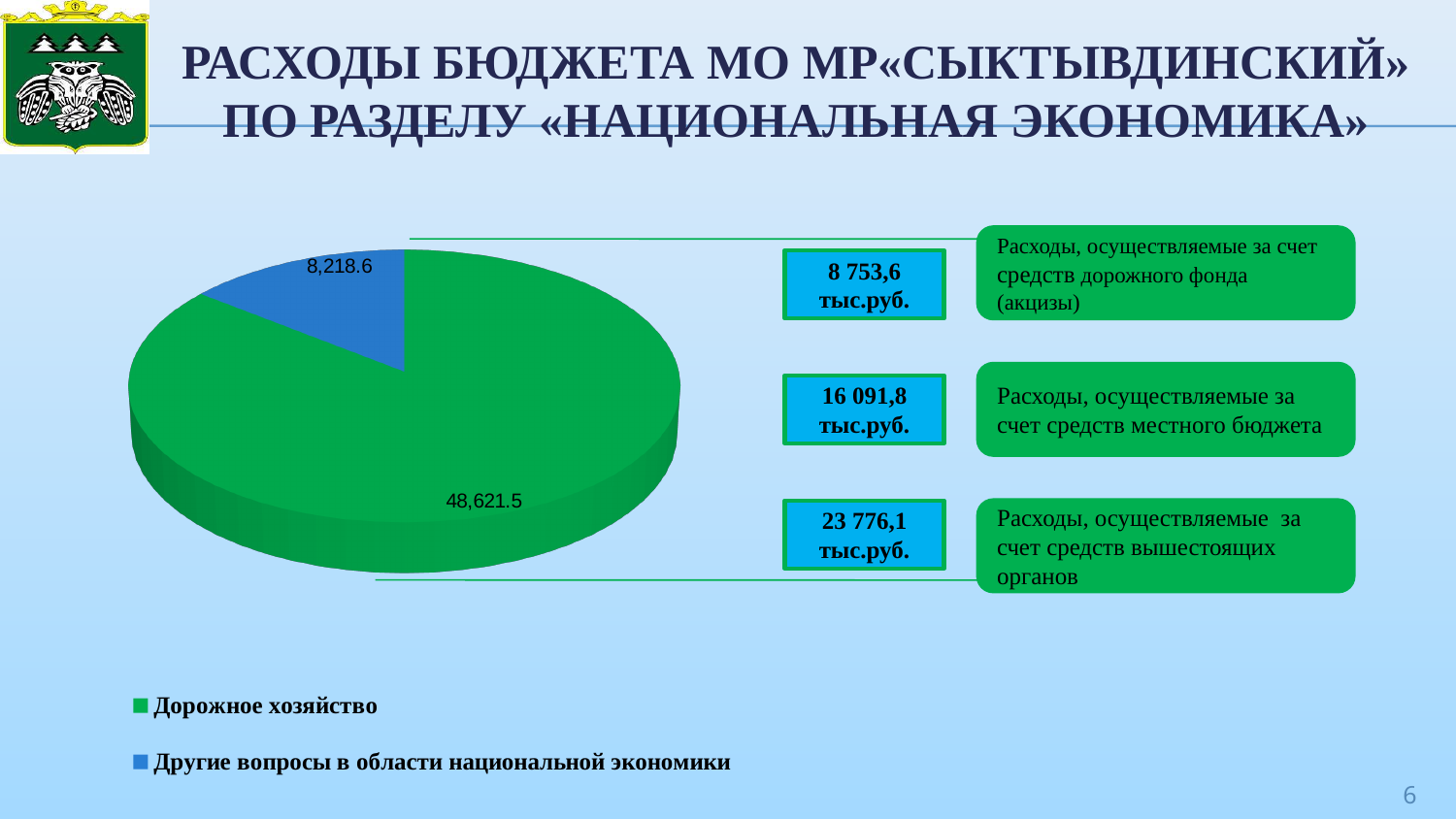
How many entries does the legend of the pie chart list? 2 Which category has the largest slice in the pie chart? Дорожное хозяйство What is the value for Другие вопросы в области национальной экономики in the pie chart? 8,218.6 Which category has the smallest slice in the pie chart? Другие вопросы в области национальной экономики What is the value for Дорожное хозяйство in the pie chart? 48,621.5 What is the total of the two values shown in the pie chart? 56,840.1 How many slices does the pie chart have? 2 What colour is the slice for Другие вопросы в области национальной экономики in the pie chart? blue What type of chart is shown on the slide? pie chart What colour is the slice for Дорожное хозяйство in the pie chart? green What is the difference between the values for Дорожное хозяйство and Другие вопросы в области национальной экономики? 40,402.9 Which is larger: the value for Дорожное хозяйство or the value for Другие вопросы в области национальной экономики? Дорожное хозяйство